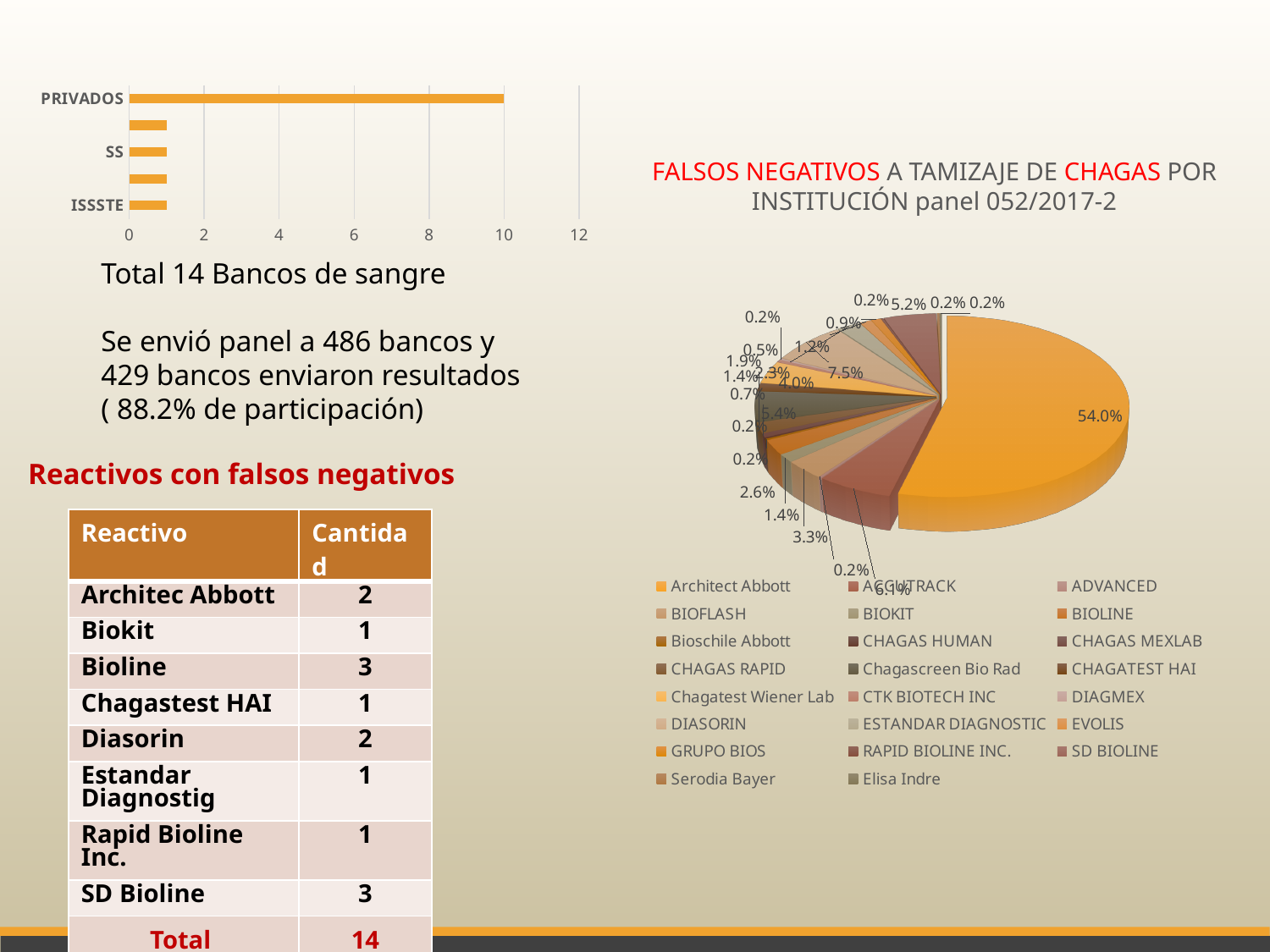
In the bar chart in the top-left of the slide, what is the highest value shown on the x axis? 12 How many entries does the legend of the pie chart on the right of the slide list? 23 What kind of chart is the chart titled 'FALSOS NEGATIVOS A TAMIZAJE DE CHAGAS POR INSTITUCIÓN panel 052/2017-2'? pie chart What kind of chart is the chart in the top-left of the slide? bar chart In the pie chart on the right of the slide, what is the share of the largest slice? 54.0% In the bar chart in the top-left of the slide, what value does the PRIVADOS bar reach on the x axis? 10 In the bar chart in the top-left of the slide, which category has the highest value? PRIVADOS In the pie chart on the right of the slide, what is the share of the second-largest labelled slice? 7.5% In the bar chart in the top-left of the slide, which is larger, the value for PRIVADOS or the value for SS? PRIVADOS What is the title of the pie chart on the right of the slide? FALSOS NEGATIVOS A TAMIZAJE DE CHAGAS POR INSTITUCIÓN panel 052/2017-2 In the bar chart in the top-left of the slide, is the value for ISSSTE greater or less than 2? less In the bar chart in the top-left of the slide, is the value for PRIVADOS greater or less than 8? greater